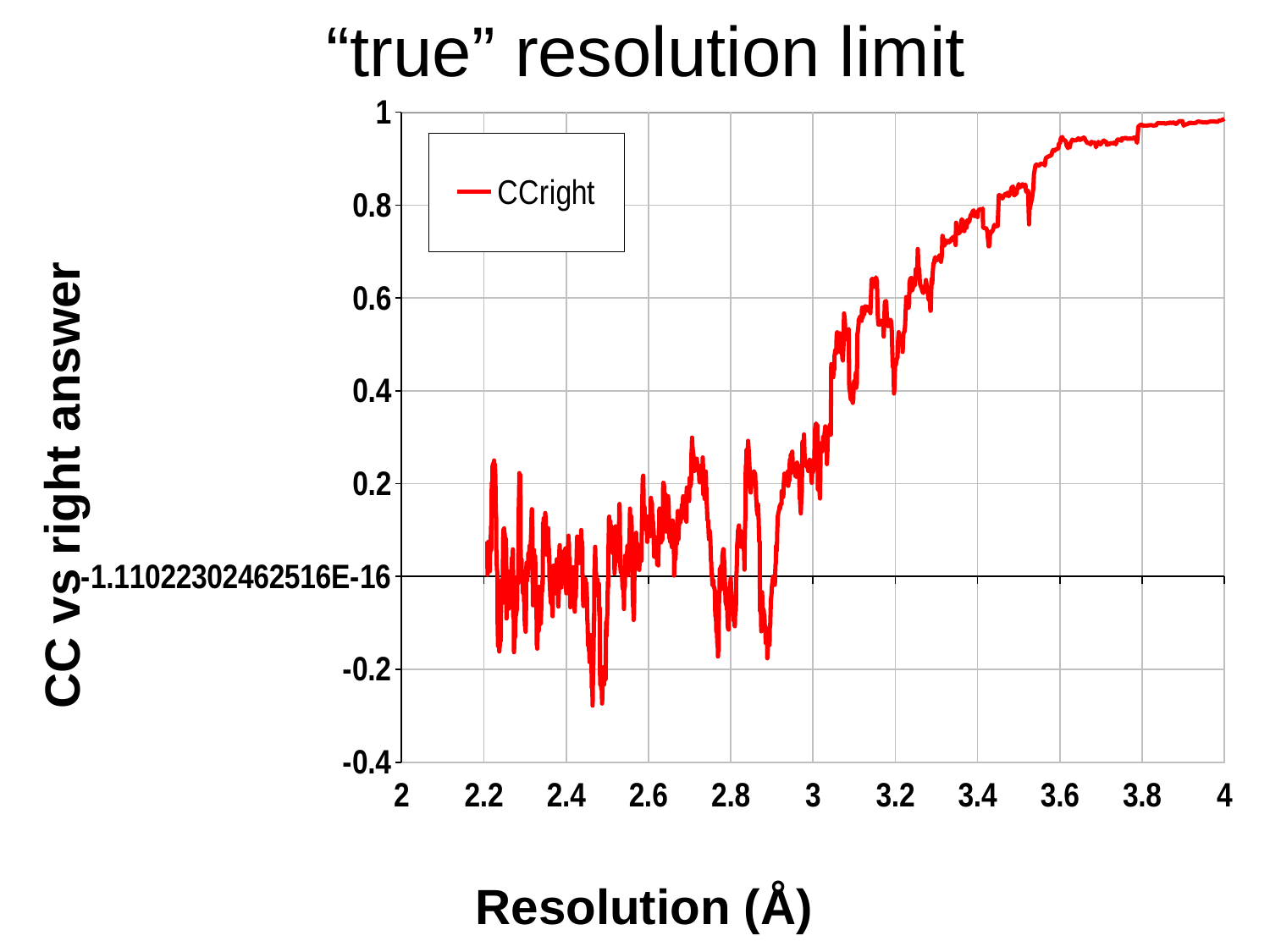
What is the title of the chart? "true" resolution limit What is the name of the series shown in the legend? CCright Is the CCright value at a resolution of 3 Å greater or less than 0.4? less Is the CCright value at a resolution of 4 Å greater or less than 0.8? greater Is the CCright value at a resolution of 2.4 Å greater or less than 0.2? less How many series does the legend list? 1 Is the CCright value higher at a resolution of 3.8 Å or at 2.6 Å? 3.8 Å What kind of chart is shown on the slide? Line chart Overall, does the CCright value rise or fall as resolution increases from 2.2 to 4 Å? Rise